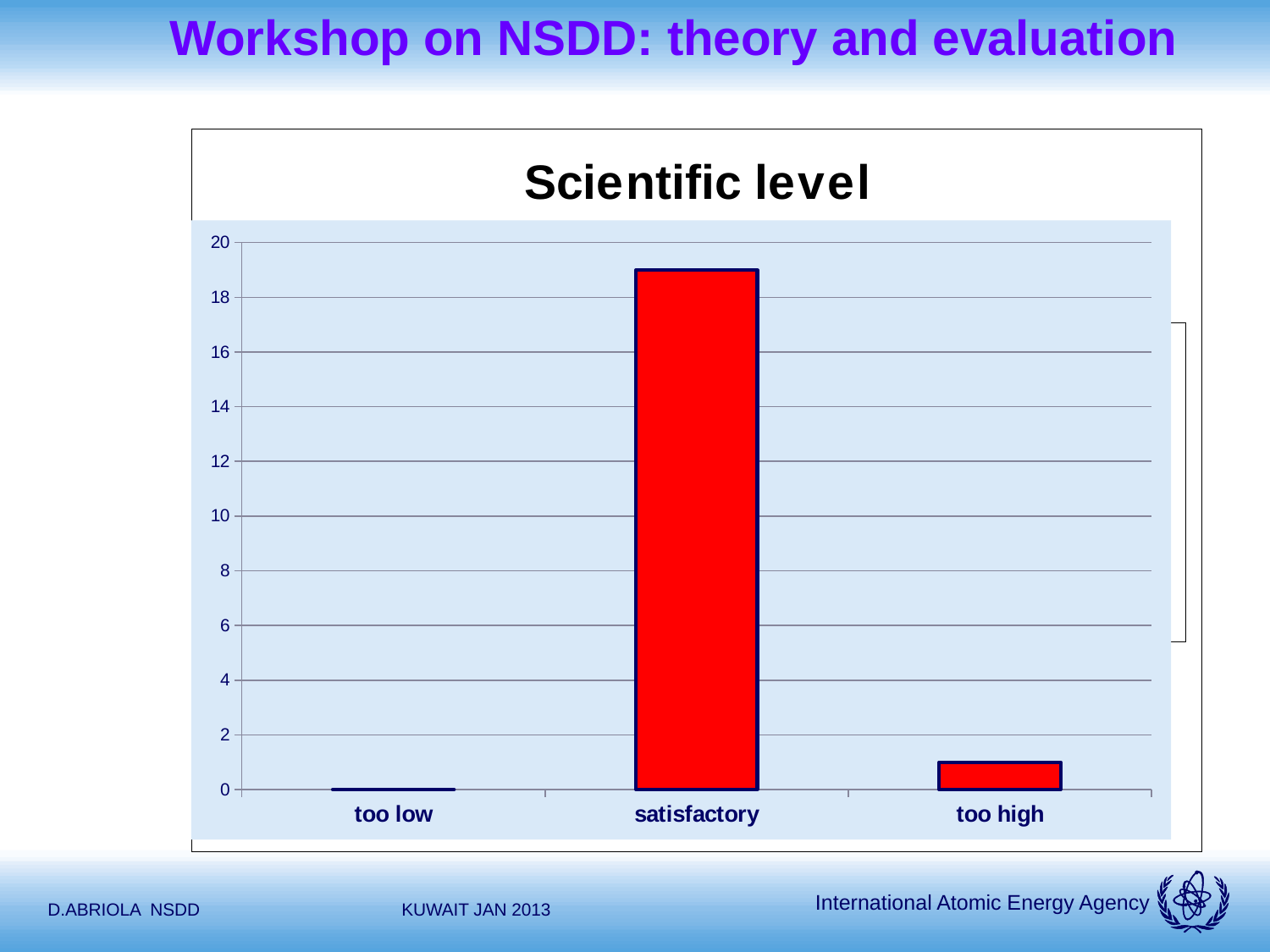
Which is larger, the value for 'too high' or the value for 'too low'? too high How many categories are shown on the x axis of the chart? 3 Which category has the highest value in the chart? satisfactory Is the value for 'satisfactory' greater or less than 18? greater Is the value for 'satisfactory' greater or less than 20? less What type of chart is shown on the slide? bar chart What is the maximum value shown on the y axis of the chart? 20 Which is larger, the value for 'satisfactory' or the value for 'too high'? satisfactory Which category has the lowest value in the chart? too low What is the title of the chart? Scientific level Is the value for 'too high' greater or less than 2? less What is the value for 'too low' in the chart? 0